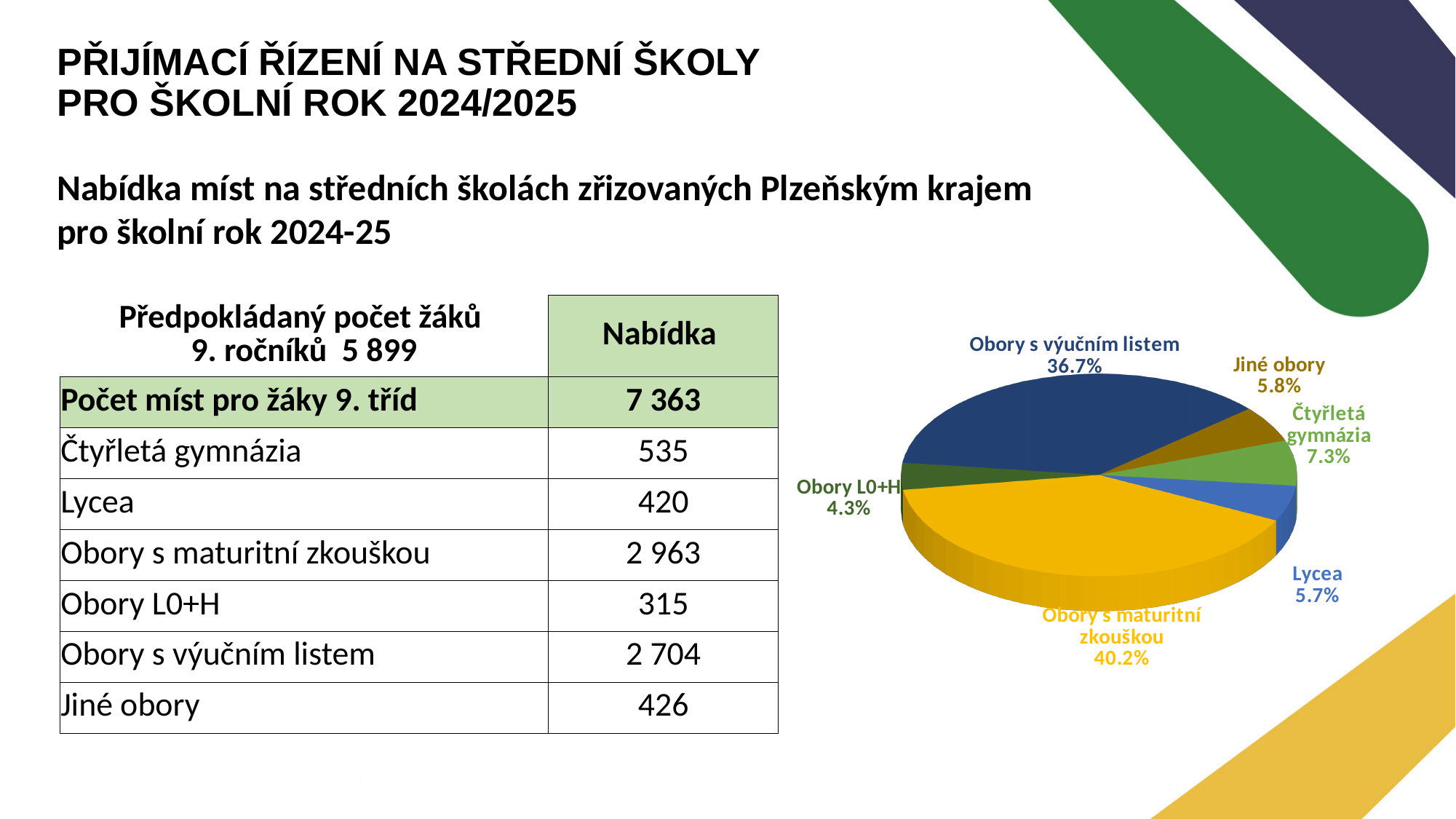
How many slices does the pie chart have? 6 By how many percentage points does the Obory s maturitní zkouškou slice exceed the Obory s výučním listem slice? 3.5 What share of the pie chart is labelled for Obory s maturitní zkouškou? 40.2% Which slice of the pie chart is the largest? Obory s maturitní zkouškou What percentage is shown for Jiné obory in the pie chart? 5.8% What share of the pie chart is labelled for Obory s výučním listem? 36.7% What percentage is shown for Obory L0+H in the pie chart? 4.3% What kind of chart is shown on the slide? pie chart In the pie chart, which is larger: Čtyřletá gymnázia or Lycea? Čtyřletá gymnázia Which slice of the pie chart is the smallest? Obory L0+H What percentage is shown for Čtyřletá gymnázia in the pie chart? 7.3% What colour is the Obory s maturitní zkouškou slice in the pie chart? yellow